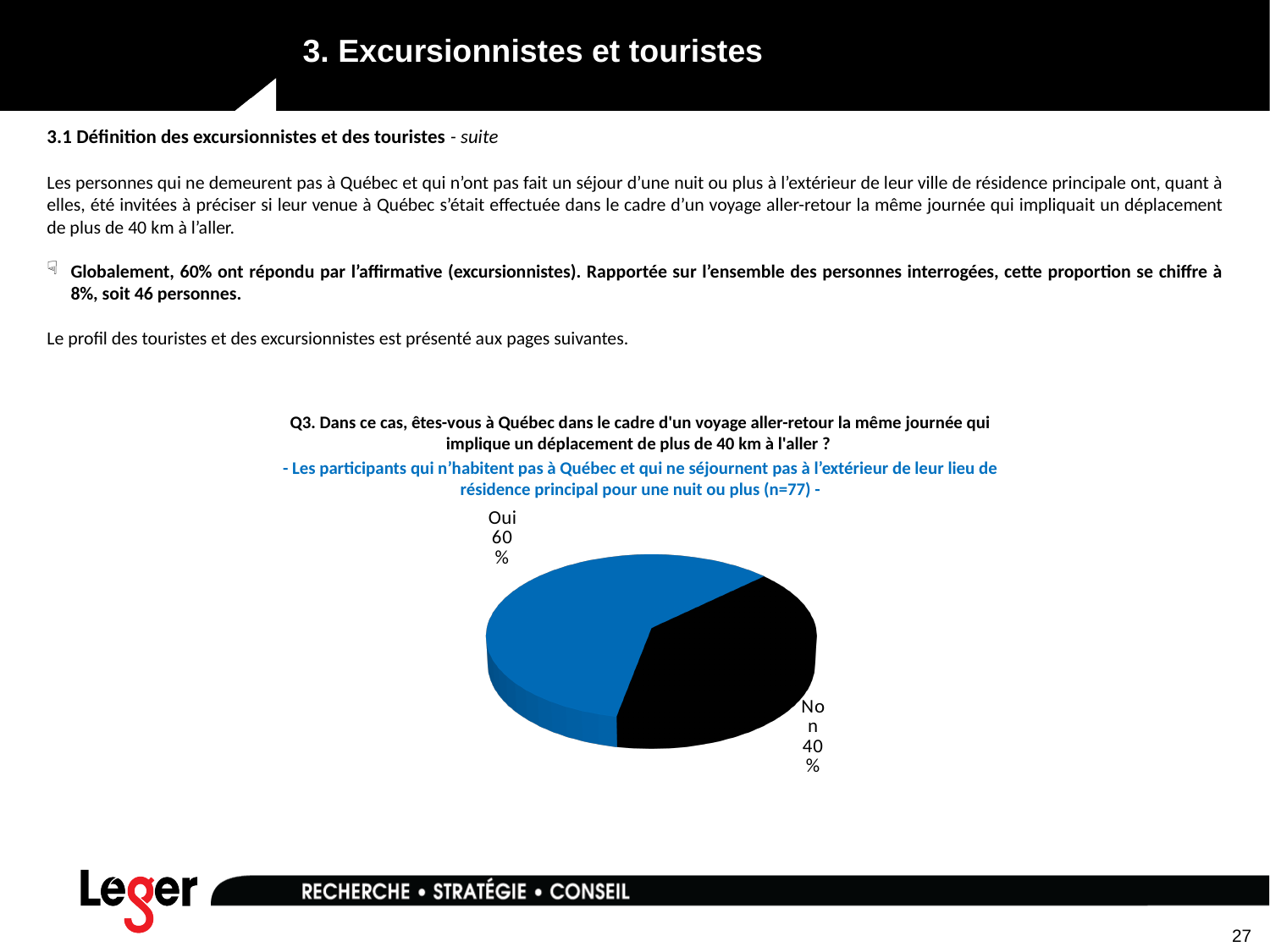
What percentage of respondents answered "Non"? 40% What is the sample size (n) stated in the chart subtitle? n=77 Which is larger, the share for "Oui" or the share for "Non"? Oui What percentage of respondents answered "Oui"? 60% What share of the pie does the "Non" slice represent? 40% How many slices does the pie chart have? 2 Which response has the smallest share of the pie? Non What is the difference in percentage points between "Oui" and "Non"? 20 What kind of chart is shown on the slide? pie chart What colour is the "Oui" slice of the pie chart? blue Which response has the largest share of the pie? Oui